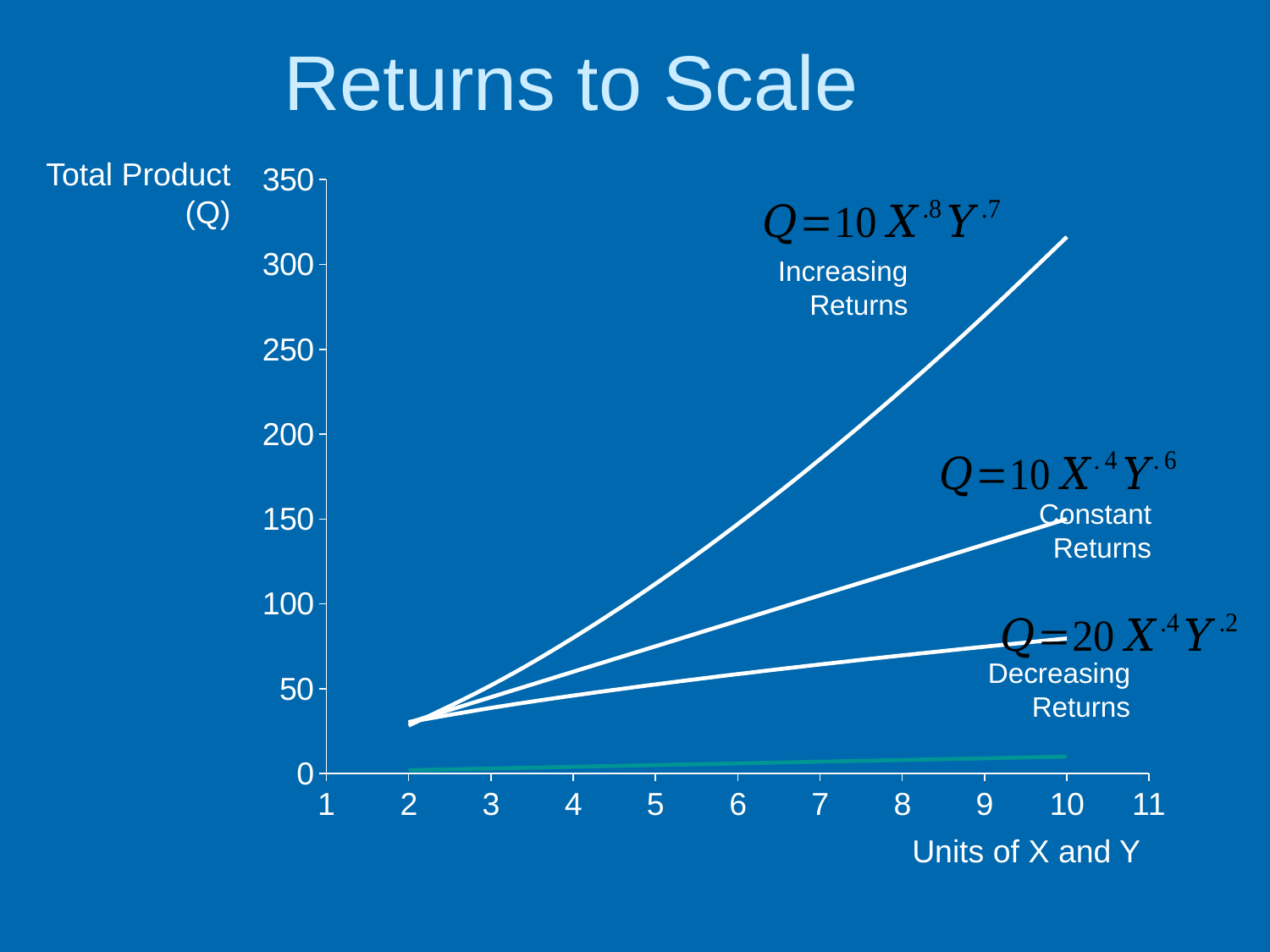
Is the value of the Increasing Returns curve at 8 units greater or less than 200? greater Which labeled curve has the lowest value at 10 units? Decreasing Returns How many labeled curves are plotted on the chart? 3 Does the Increasing Returns curve rise or fall as Units of X and Y increase? rise At 10 units, which curve has the larger value: Increasing Returns or Constant Returns? Increasing Returns What is the label on the x axis? Units of X and Y What kind of chart is shown on the slide? line chart Is the value of the Increasing Returns curve at 10 units greater or less than 300? greater Which labeled curve has the highest value at 10 units? Increasing Returns What is the title of the chart? Returns to Scale Is the value of the Constant Returns curve at 10 units greater or less than 100? greater